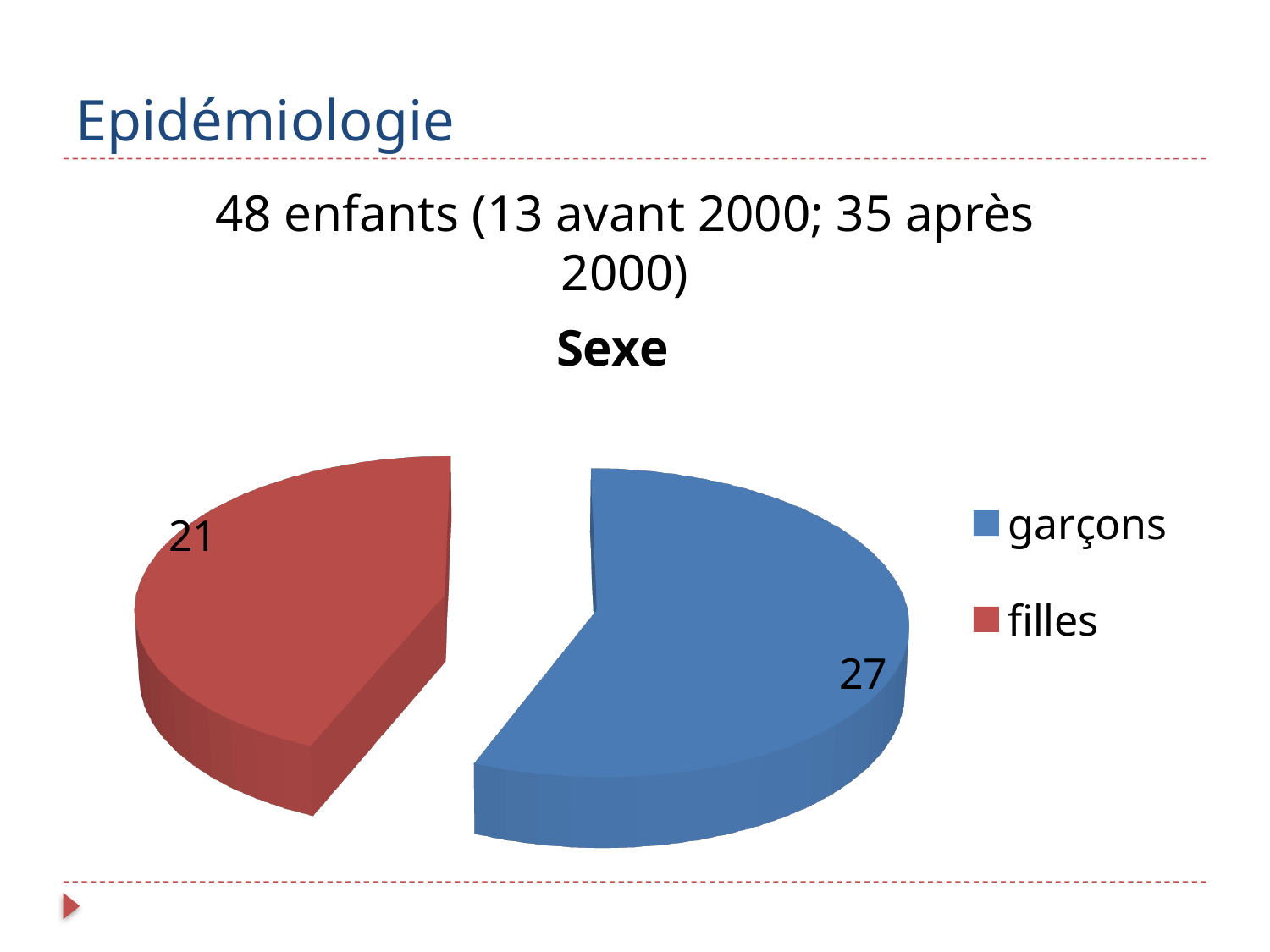
Which is larger, the value for garçons or the value for filles? garçons What kind of chart is shown on the slide? pie chart What is the total of the two slices in the Sexe pie chart? 48 Which category has the largest slice in the Sexe pie chart? garçons What is the value for garçons in the Sexe pie chart? 27 Which category has the smallest slice in the Sexe pie chart? filles Which colour represents filles in the pie chart? red What is the title of the chart? Sexe How many categories does the Sexe pie chart show? 2 What is the difference between the number of garçons and the number of filles? 6 What is the value for filles in the Sexe pie chart? 21